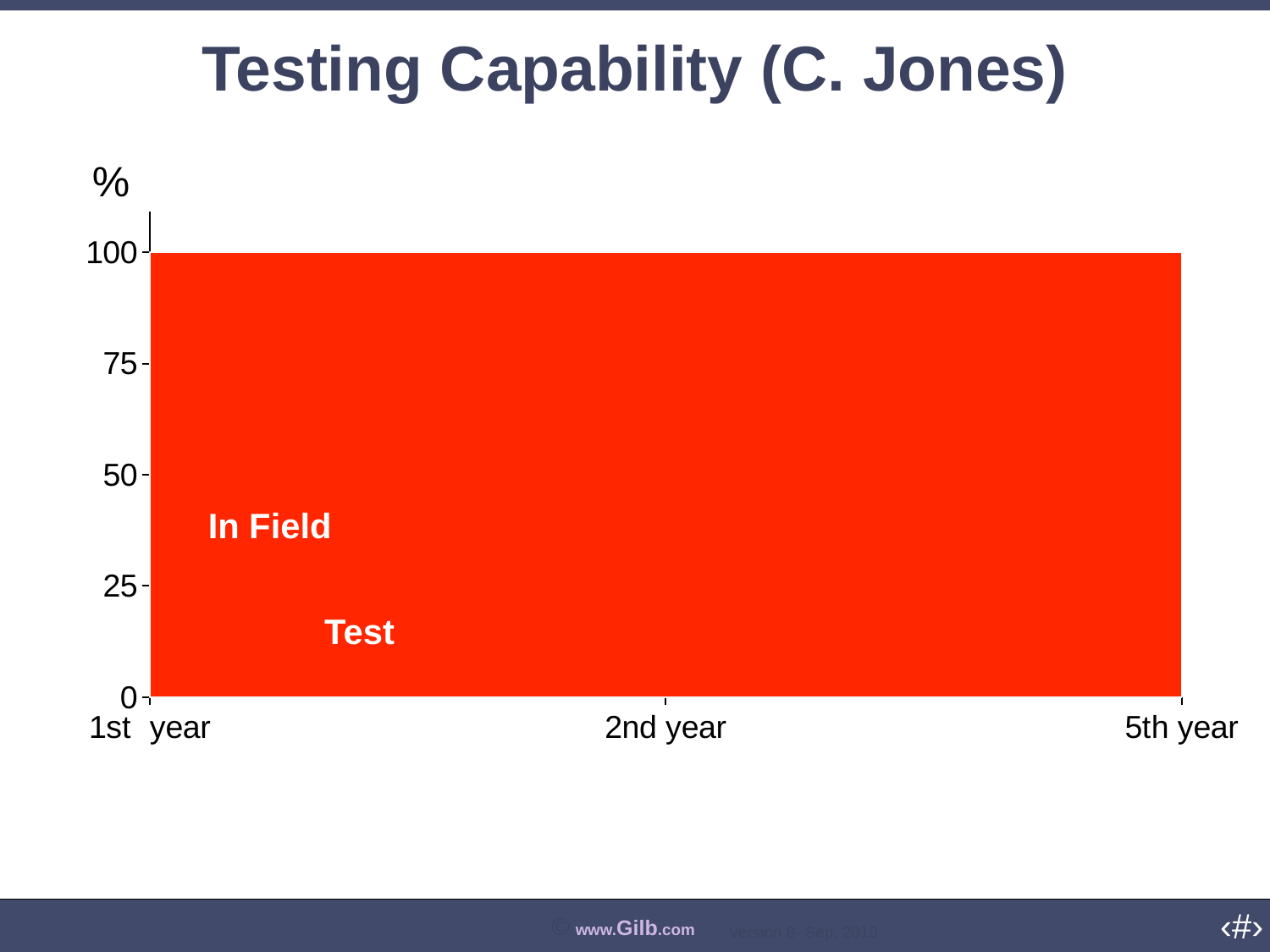
What is the label of the last category on the x axis? 5th year What unit is shown at the top of the y axis? % What is the label of the first category on the x axis? 1st year How many categories are labelled along the x axis? 3 At 1st year, is the top of the red area greater or less than 75? greater What is the title of the chart? Testing Capability (C. Jones) At 5th year, is the top of the red area greater or less than 50? greater What kind of chart is shown on the slide? area chart What is the highest tick value shown on the y axis? 100